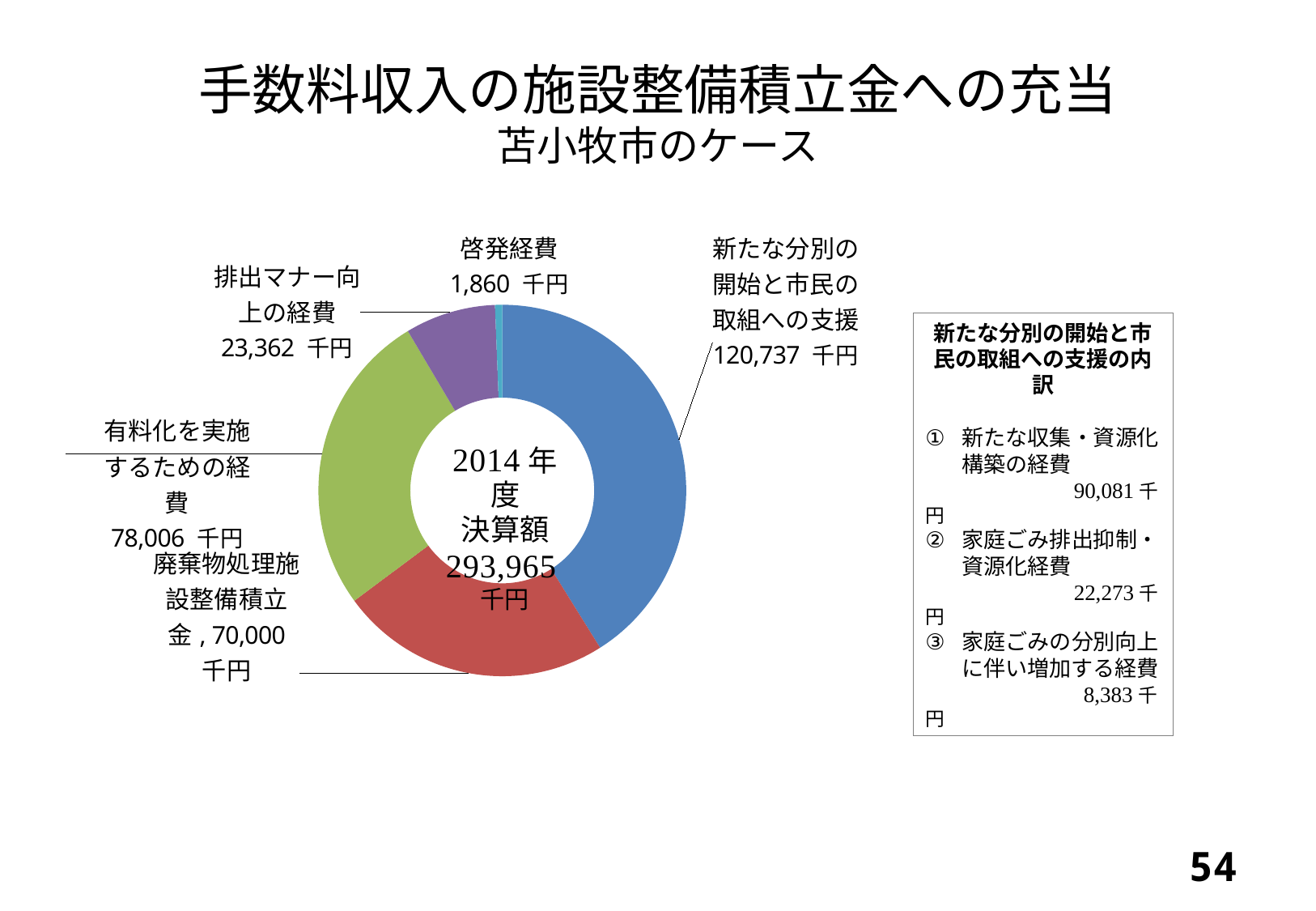
What is the value for 廃棄物処理施設整備積立金 in the doughnut chart? 70,000 千円 What kind of chart is shown on the slide? doughnut chart What is the value for 排出マナー向上の経費 in the doughnut chart? 23,362 千円 Which category has the smallest value in the doughnut chart? 啓発経費 Which is larger, 有料化を実施するための経費 or 廃棄物処理施設整備積立金? 有料化を実施するための経費 What is the difference between 新たな分別の開始と市民の取組への支援 and 有料化を実施するための経費? 42,731 千円 What total amount (2014年度決算額) is shown in the centre of the doughnut chart? 293,965 千円 What is the value for 啓発経費 in the doughnut chart? 1,860 千円 How many categories (slices) does the doughnut chart show? 5 Which category has the largest value in the doughnut chart? 新たな分別の開始と市民の取組への支援 What is the value for 新たな分別の開始と市民の取組への支援 in the doughnut chart? 120,737 千円 What is the value for 有料化を実施するための経費 in the doughnut chart? 78,006 千円